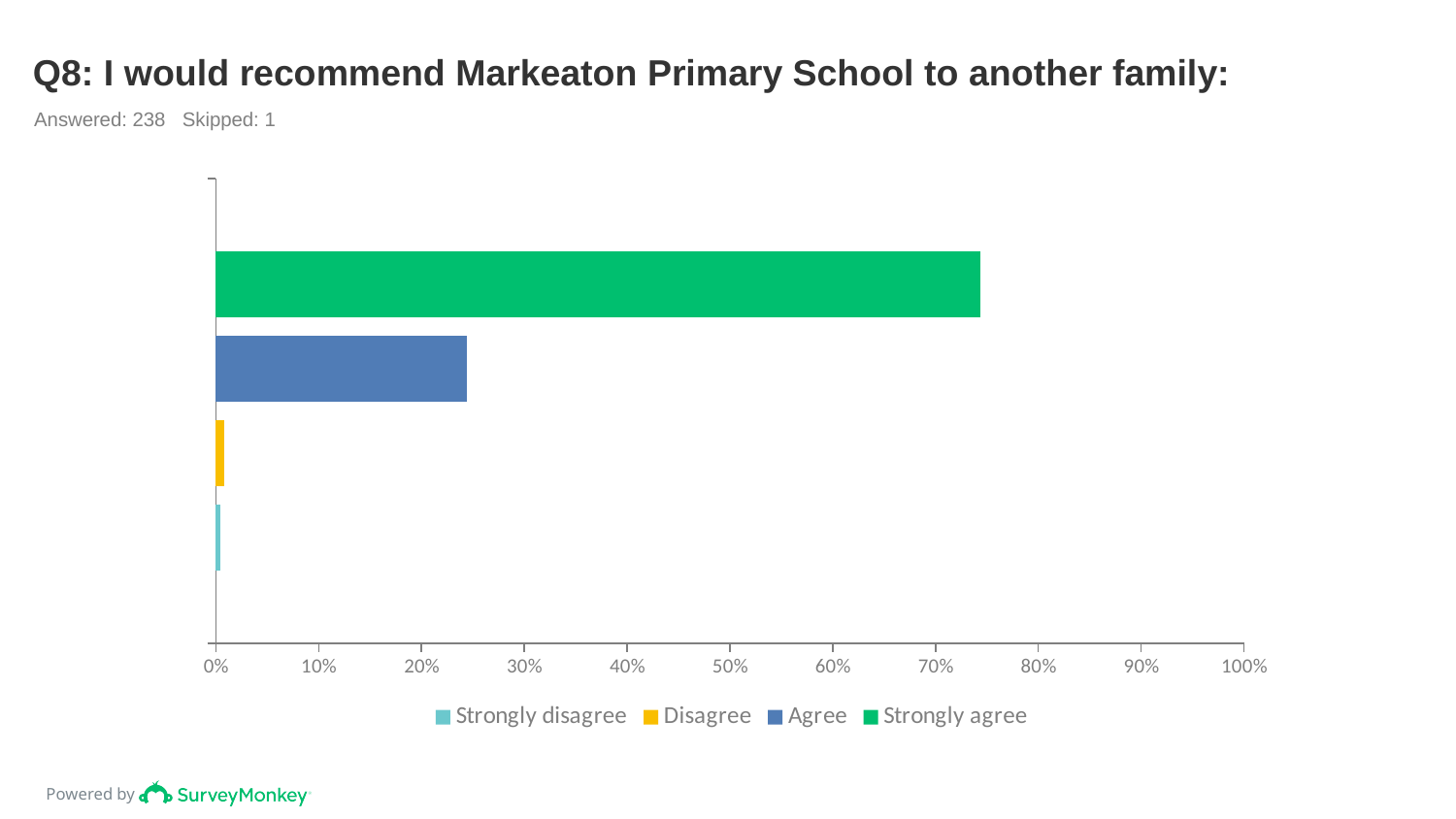
Which is larger, the value for Strongly agree or the value for Agree? Strongly agree What kind of chart is shown on the slide? bar chart Which is larger, the value for Agree or the value for Disagree? Agree Is the value for Strongly agree greater or less than 70%? greater What colour represents Strongly agree in the legend? green Is the value for Agree greater or less than 30%? less Which response option has the highest value? Strongly agree Is the value for Agree greater or less than 20%? greater How many series does the legend list? 4 What is the title of the chart? Q8: I would recommend Markeaton Primary School to another family: